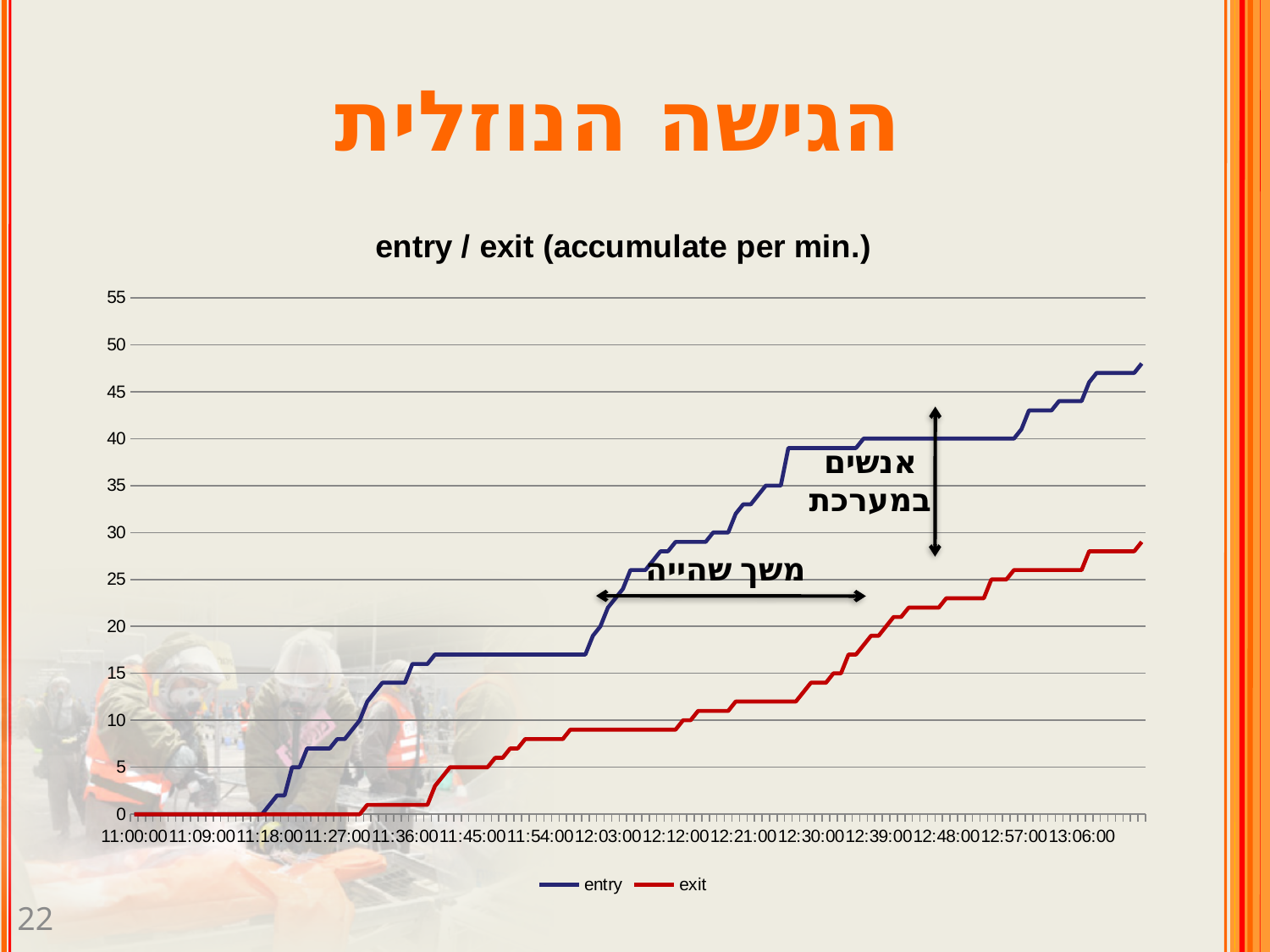
Is the value for entry at 12:03:00 greater or less than 15? greater Which series is drawn in blue? entry Is the value for exit at 12:03:00 greater or less than 10? less Do the values of the exit series rise or fall along the x axis? rise Is the value for exit at 13:06:00 greater or less than 25? greater How many series does the legend list? 2 At 12:30:00, which series has the larger value, entry or exit? entry Do the values of the entry series rise or fall along the x axis? rise What kind of chart is shown on the slide? line chart What is the title of the chart? entry / exit (accumulate per min.) Which series reaches the higher value at the right end of the chart, entry or exit? entry